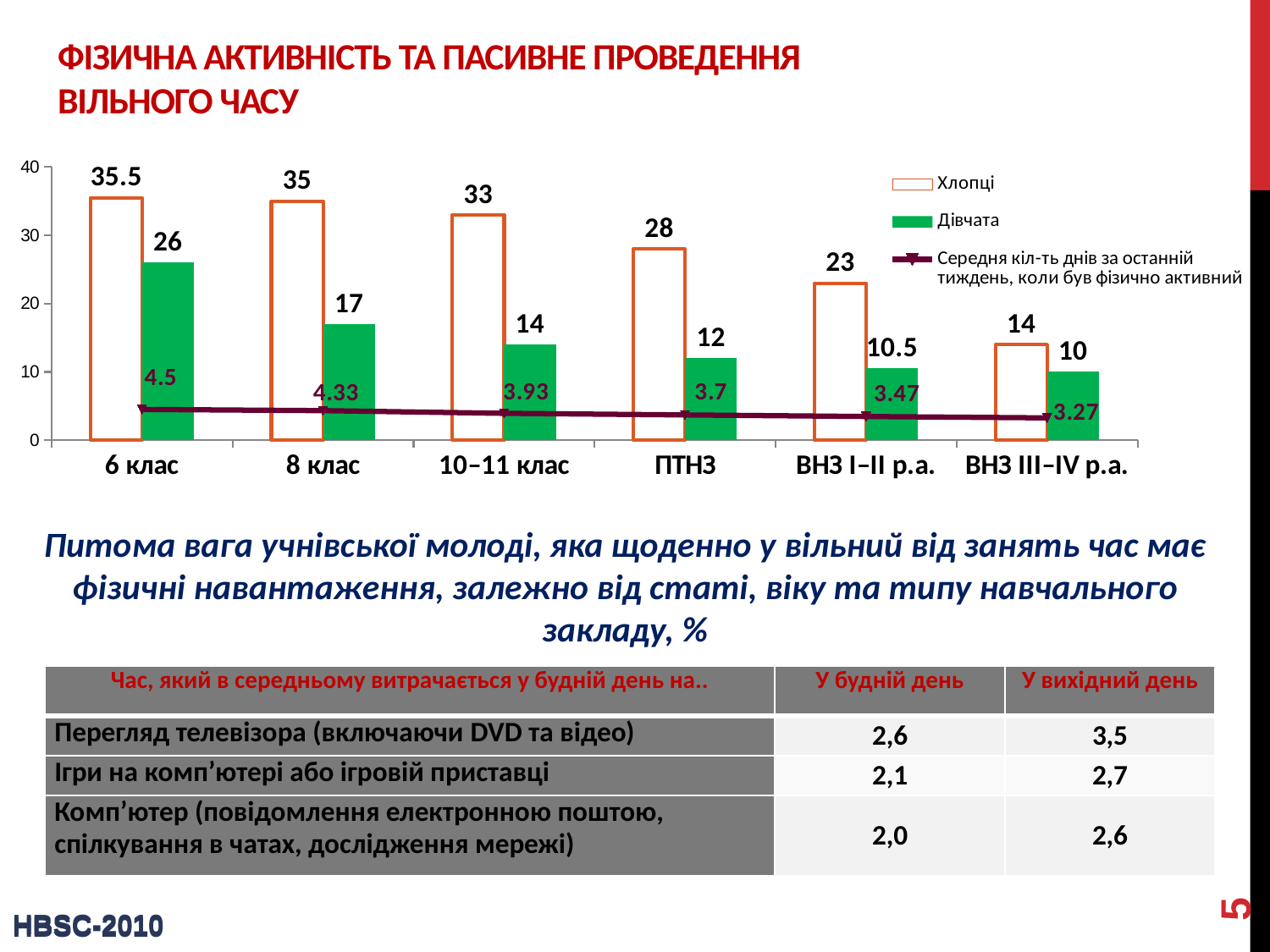
Is the value for Хлопці in the ПТНЗ category greater or less than 20? greater Which category has the highest value for Хлопці? 6 клас What colour are the bars for Дівчата? green What is the value of the line series (Середня кіл-ть днів за останній тиждень, коли був фізично активний) for 10–11 клас? 3.93 What is the value for Хлопці in the 6 клас category? 35.5 How many categories are shown on the x axis? 6 Which category has the lowest value for Дівчата? ВНЗ III–IV р.а. Which is larger in the ВНЗ I–II р.а. category: the value for Хлопці or for Дівчата? Хлопці How many series does the legend list? 3 Do the values of the line series rise or fall from 6 клас to ВНЗ III–IV р.а.? fall What is the difference between the Хлопці and Дівчата values in the 8 клас category? 18 What is the value for Дівчата in the ПТНЗ category? 12